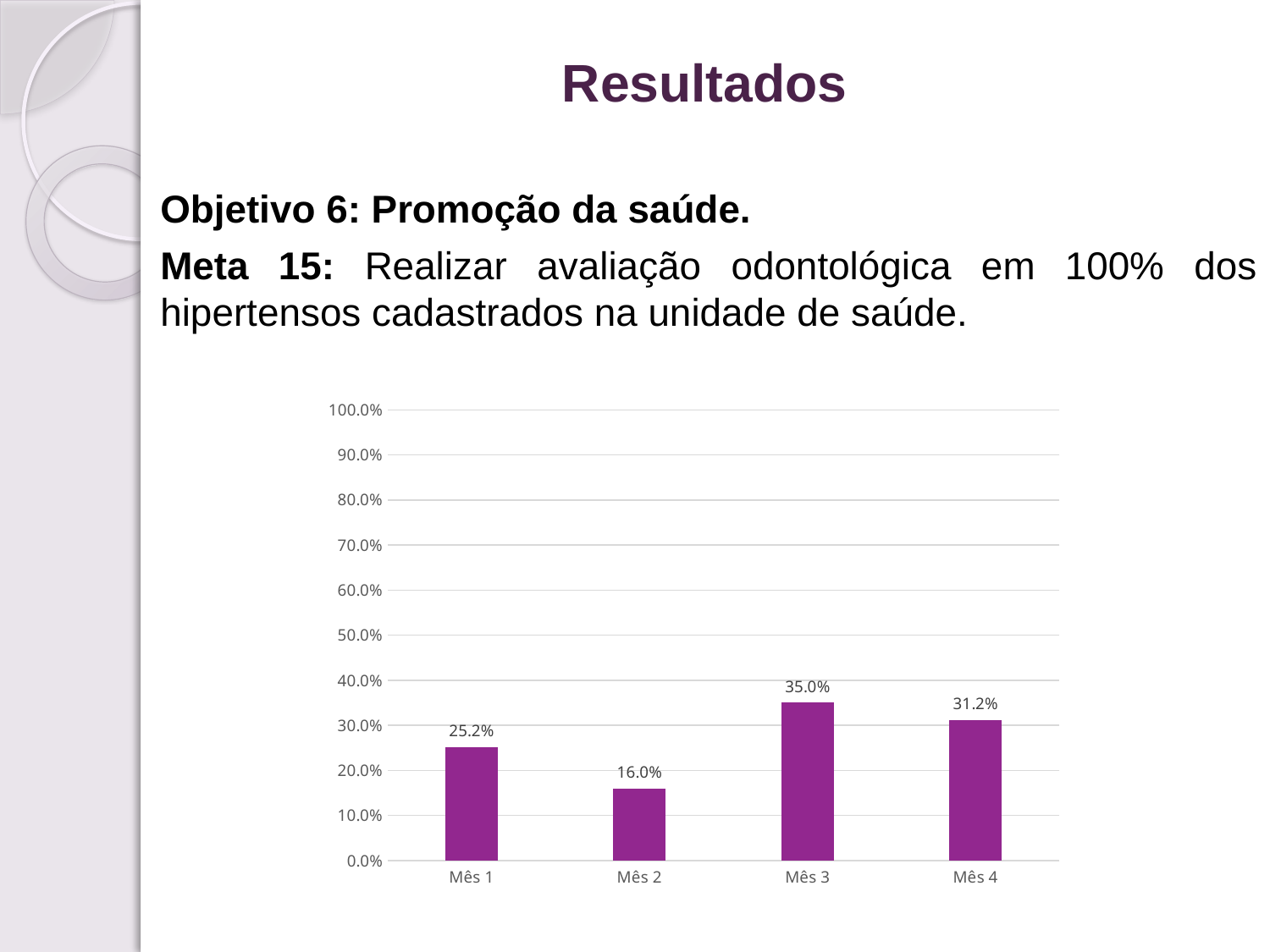
How many months are shown on the x axis? 4 What is the value for Mês 2? 16.0% What is the value for Mês 4? 31.2% What is the difference between the values for Mês 4 and Mês 1? 6.0% Is the value for Mês 3 greater or less than 30.0%? greater What is the value for Mês 1? 25.2% What is the difference between the values for Mês 3 and Mês 2? 19.0% Which is larger, the value for Mês 1 or the value for Mês 4? Mês 4 Which month has the lowest value? Mês 2 What is the value for Mês 3? 35.0% What kind of chart is shown on the slide? bar chart Which month has the highest value? Mês 3